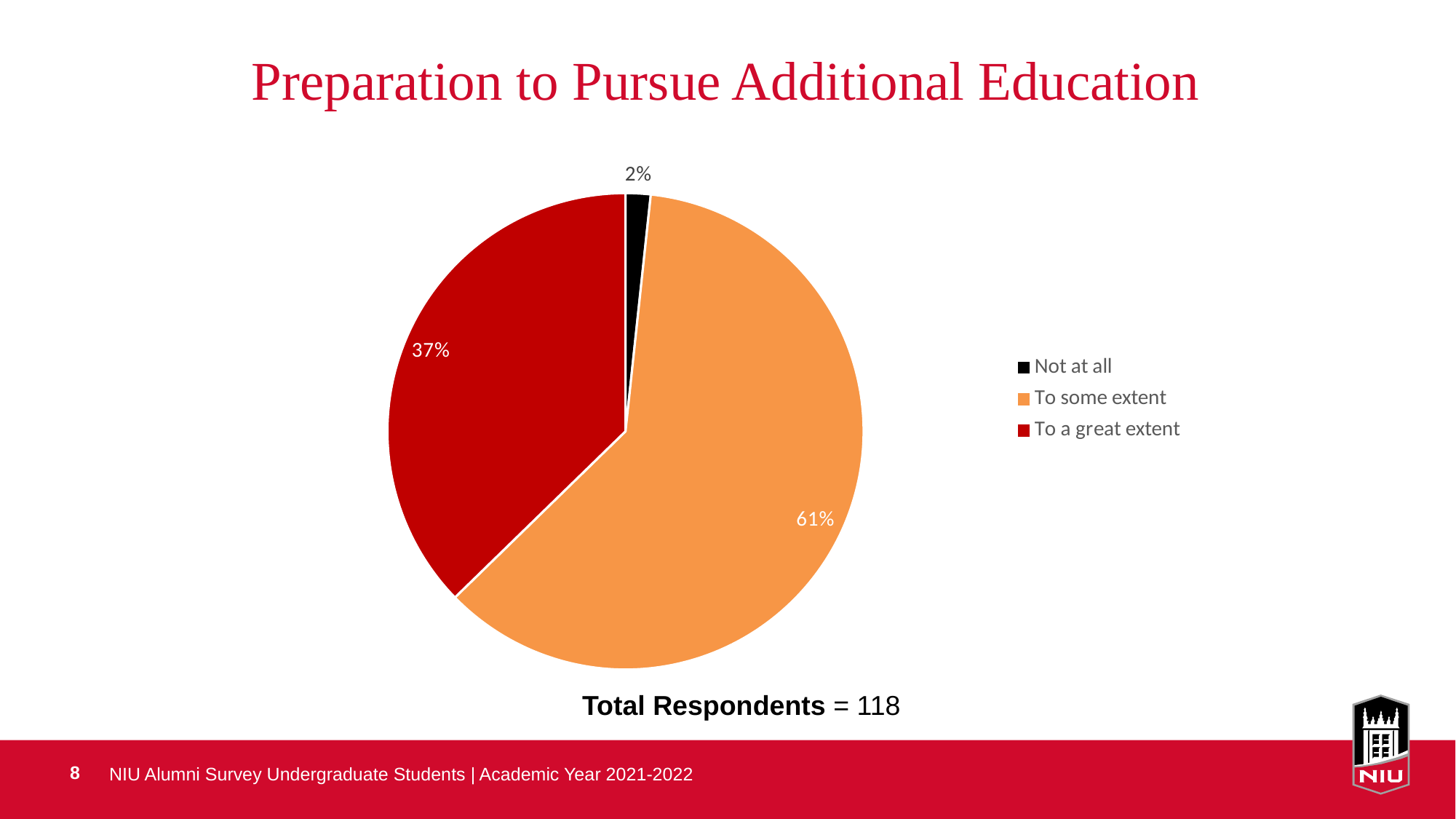
Which is larger, the slice for "To a great extent" or the slice for "Not at all"? To a great extent What is the total number of respondents stated below the chart? 118 What is the combined share of "To some extent" and "To a great extent"? 98% What is the difference in percentage points between "To some extent" and "To a great extent"? 24 What colour is the slice for "To a great extent"? Red What kind of chart is shown on the slide? Pie chart How many categories does the pie chart show? 3 What share of the pie is labelled "To a great extent"? 37% What share of the pie is labelled "To some extent"? 61% Which category has the smallest slice of the pie? Not at all What share of the pie is labelled "Not at all"? 2% Which category has the largest slice of the pie? To some extent